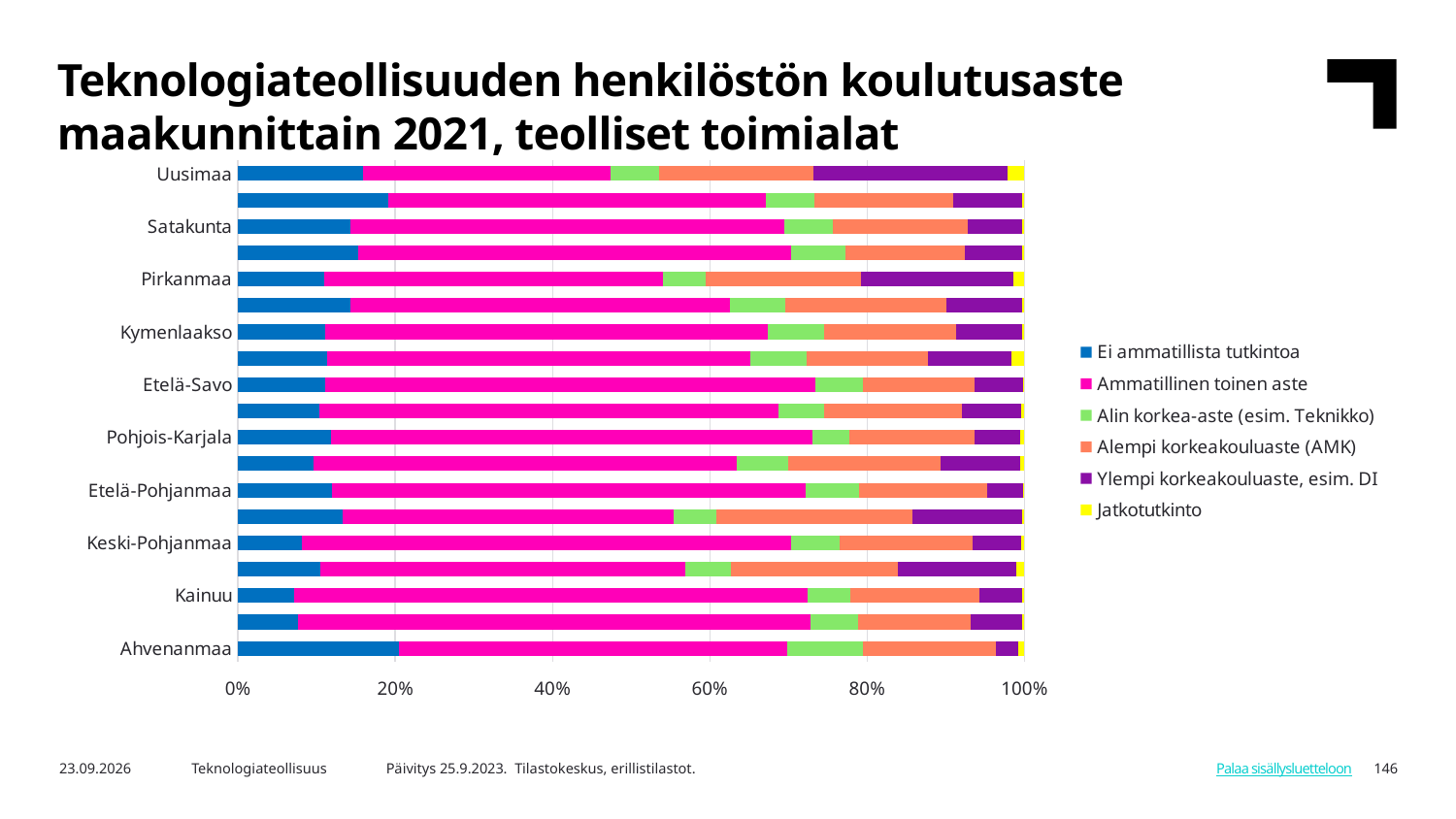
How many series does the legend list? 6 What kind of chart is shown on the slide? Stacked bar chart Is the 'Ei ammatillista tutkintoa' share for Uusimaa greater or less than 20%? less Which has the larger 'Ammatillinen toinen aste' share, Kainuu or Uusimaa? Kainuu Is the 'Ammatillinen toinen aste' share for Kainuu greater or less than 60%? greater Is the 'Ei ammatillista tutkintoa' share for Pirkanmaa greater or less than 20%? less Which region has the largest 'Ylempi korkeakouluaste, esim. DI' share? Uusimaa How many bars (regions) are plotted in the chart? 19 Which has the larger 'Ei ammatillista tutkintoa' share, Ahvenanmaa or Kainuu? Ahvenanmaa What is the title of the chart on the slide? Teknologiateollisuuden henkilöstön koulutusaste maakunnittain 2021, teolliset toimialat Which legend entry is shown in yellow? Jatkotutkinto